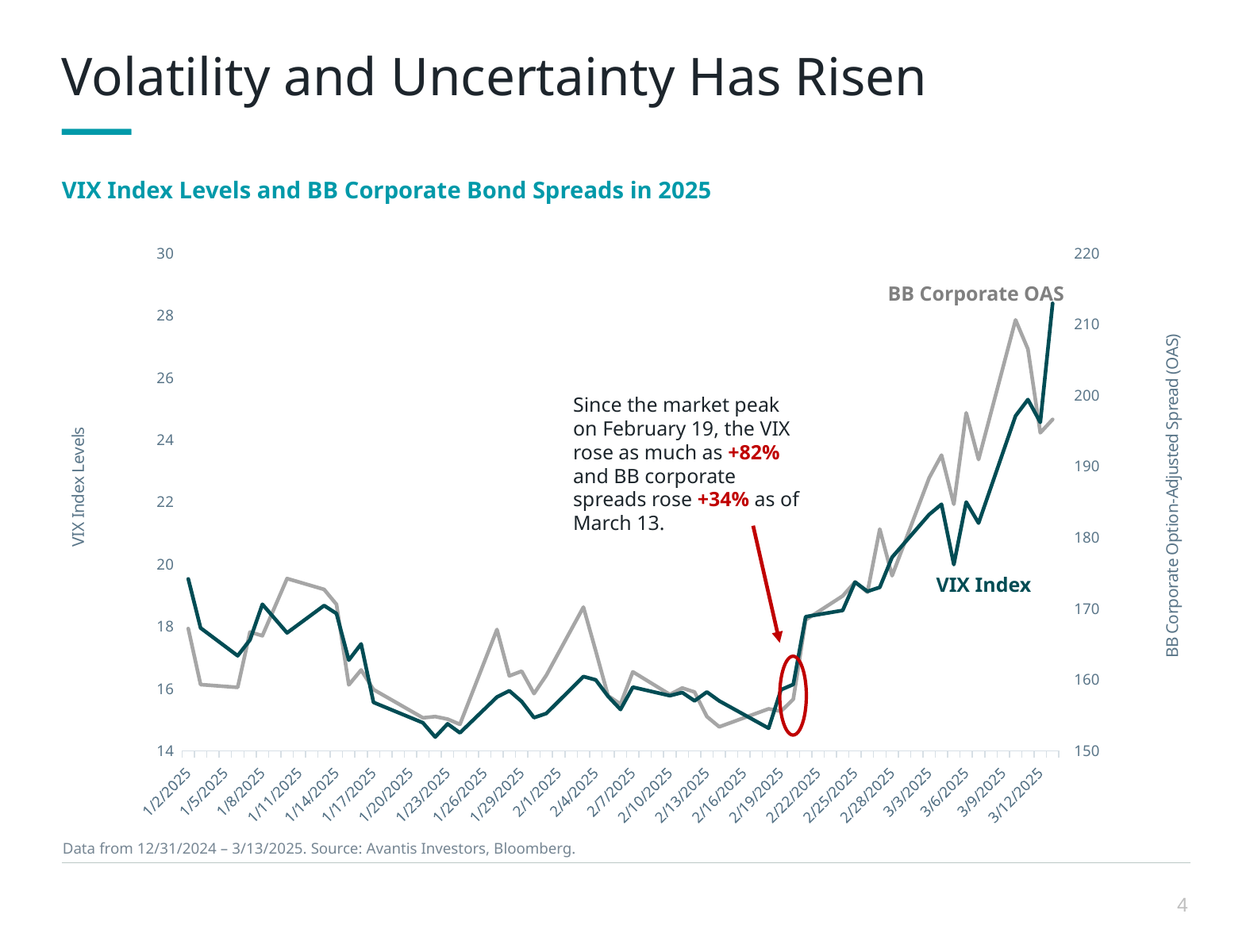
According to the annotation, by how much did the VIX rise since the February 19 market peak as of March 13? +82% How many series are plotted on the chart? 2 Does the VIX Index rise or fall between 2/19/2025 and 3/12/2025? rise According to the annotation, by how much did BB corporate spreads rise since February 19 as of March 13? +34% Is the VIX Index value on 2/19/2025 greater or less than 16? less Is the VIX Index value on 3/12/2025 greater or less than 26? less Is the BB Corporate OAS value on 1/2/2025 greater or less than 180? less What is the title of the chart? VIX Index Levels and BB Corporate Bond Spreads in 2025 What kind of chart is shown on the slide? Line chart